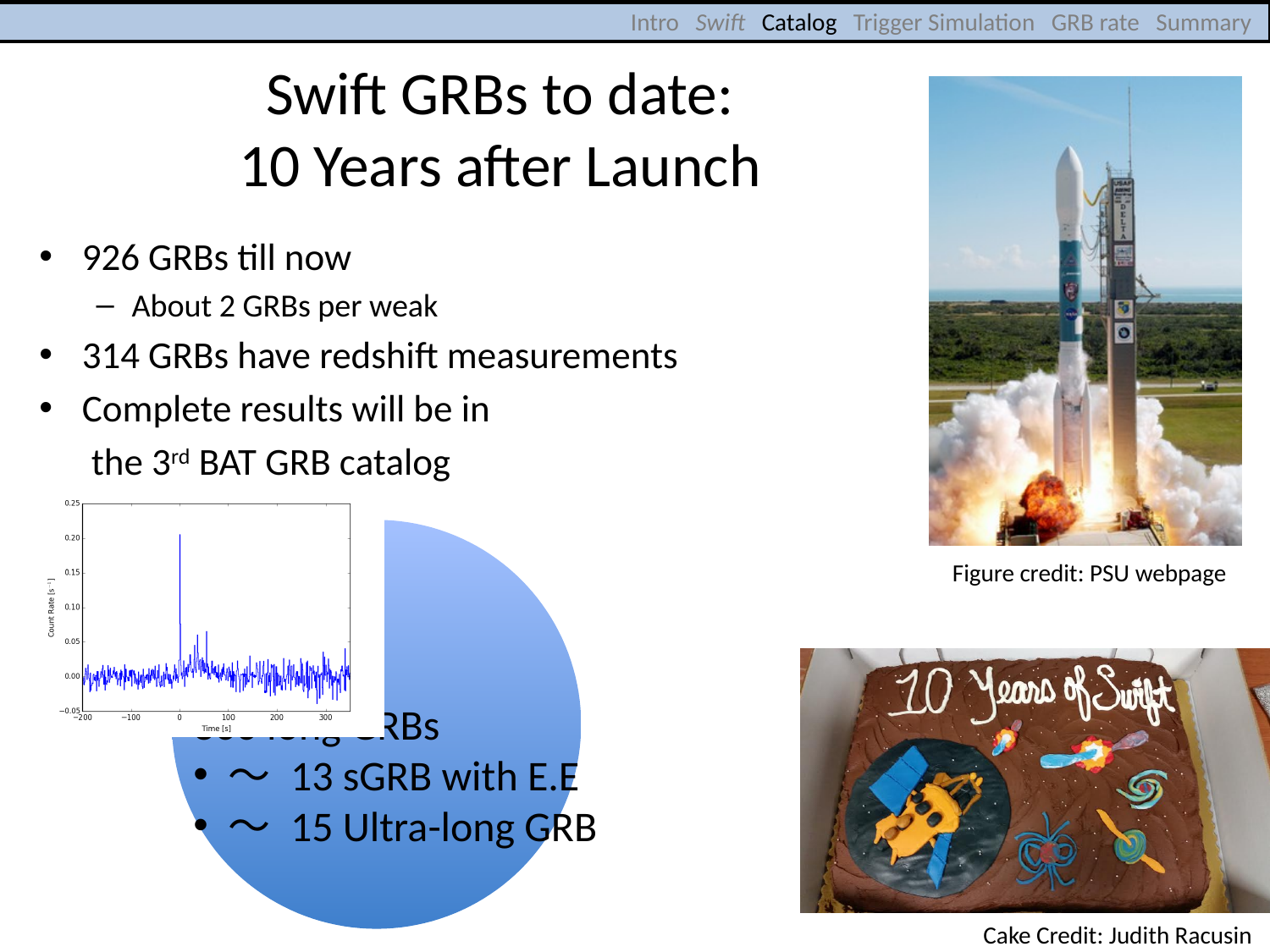
What kind of chart is shown at the bottom left of the slide? line chart In the chart at the bottom left of the slide, is the peak count rate greater or less than 0.15? greater How many data series are plotted in the chart at the bottom left of the slide? 1 What is the lowest tick value shown on the x axis of the chart at the bottom left of the slide? -200 In the chart at the bottom left of the slide, is the count rate at time -100 s greater or less than 0.05? less What is the label of the y axis of the chart at the bottom left of the slide? Count Rate [s^-1] In the chart at the bottom left of the slide, is the count rate at time 200 s greater or less than 0.10? less What is the label of the x axis of the chart at the bottom left of the slide? Time [s]